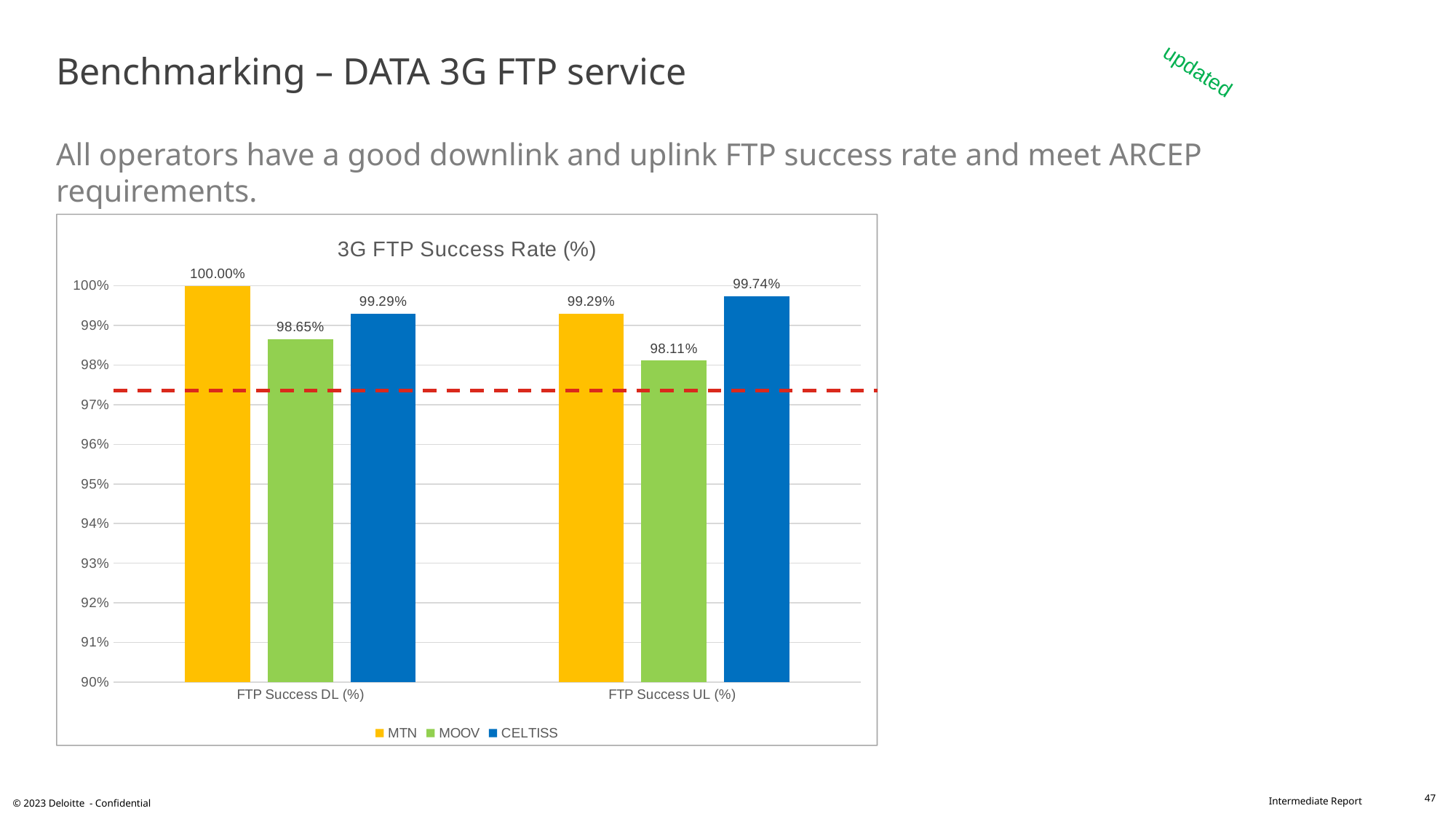
What is the difference between MTN's and MOOV's FTP Success DL (%) values? 1.35% Which is larger: CELTISS's FTP Success DL (%) or CELTISS's FTP Success UL (%)? FTP Success UL (%) How many series does the legend list? 3 Which operator has the lowest FTP Success DL (%)? MOOV What is the FTP Success DL (%) value for MTN? 100.00% Is the FTP Success UL (%) value for MOOV greater or less than 99%? less What kind of chart is shown on the slide? Bar chart What is the title of the chart? 3G FTP Success Rate (%) What is the FTP Success UL (%) value for MOOV? 98.11% Which operator has the highest FTP Success UL (%)? CELTISS What is the FTP Success UL (%) value for CELTISS? 99.74% How many categories are shown on the x axis? 2